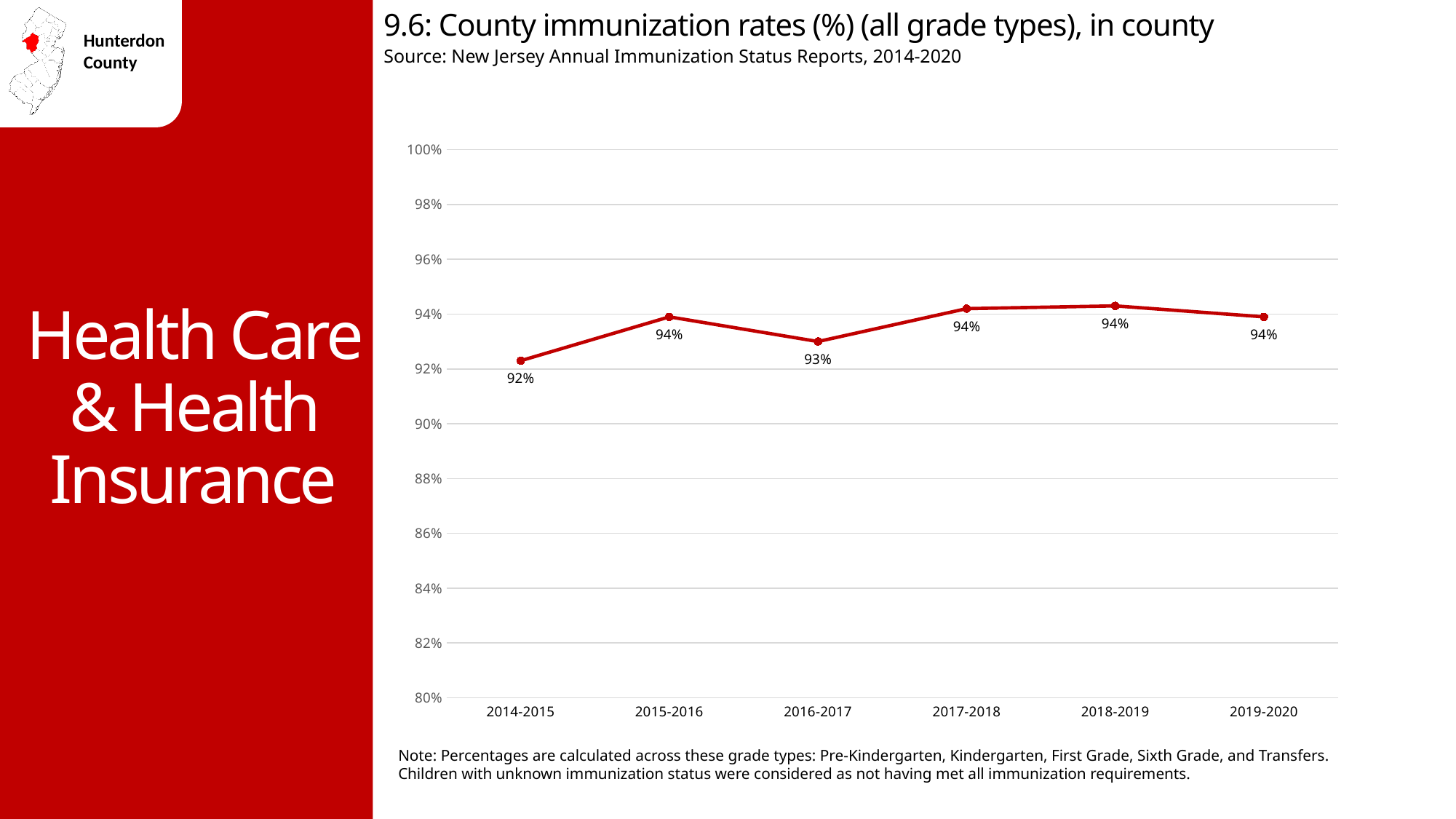
Which school year has the lowest immunization rate? 2014-2015 What is the county immunization rate for 2019-2020? 94% What is the county immunization rate for 2016-2017? 93% What is the difference between the immunization rate in 2015-2016 and in 2014-2015? 2 percentage points What is the title of the chart? 9.6: County immunization rates (%) (all grade types), in county Is the value for 2014-2015 greater or less than 90%? greater What is the county immunization rate for 2015-2016? 94% What kind of chart is shown on the slide? line chart Which is larger, the immunization rate in 2014-2015 or in 2016-2017? 2016-2017 How many school years are plotted on the chart? 6 Does the immunization rate rise or fall from 2014-2015 to 2019-2020? rise What is the county immunization rate for 2014-2015? 92%